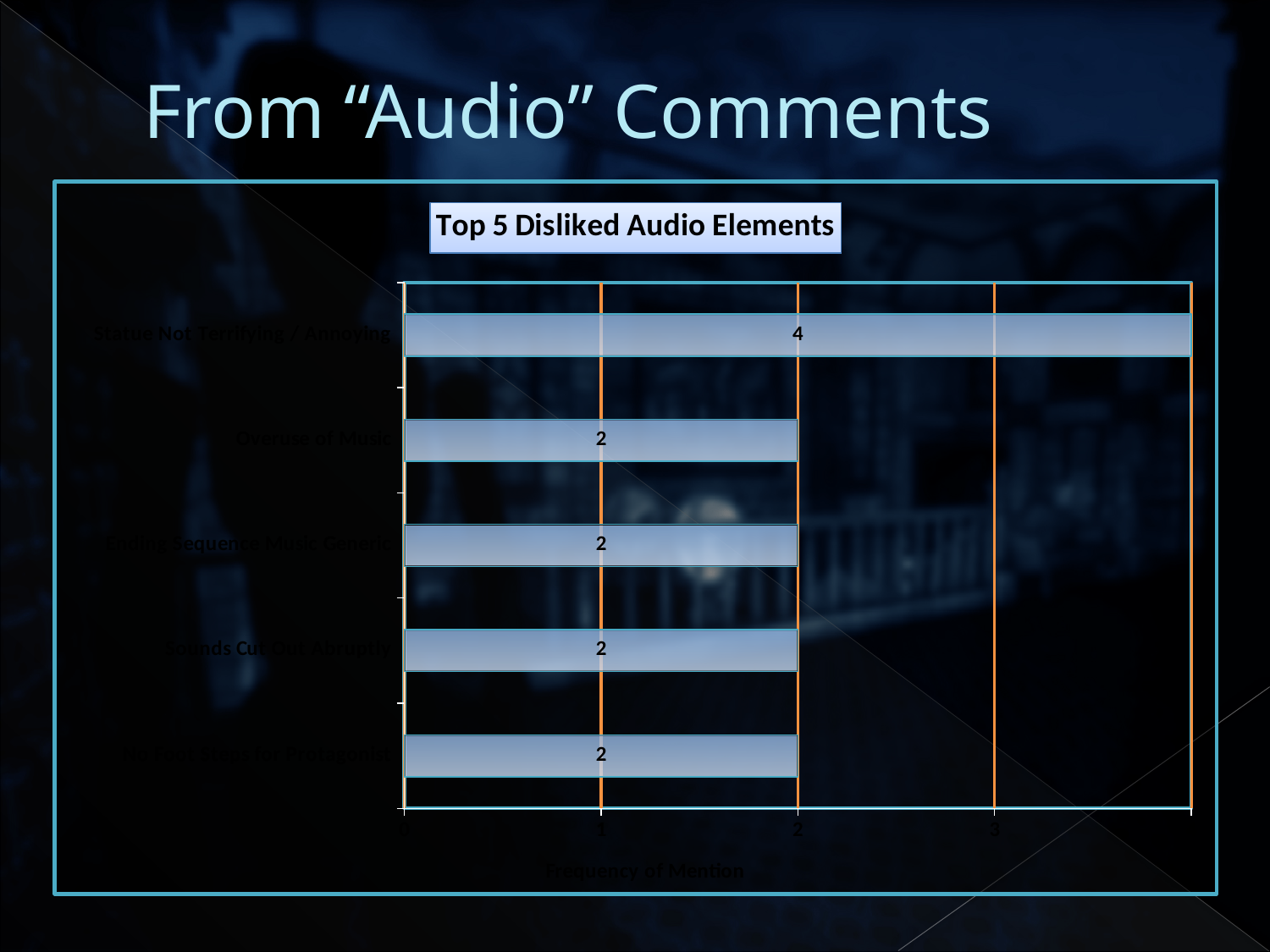
What is the value for No Foot Steps for Protagonist? 2 Is the value for Statue Not Terrifying / Annoying greater or less than 3? greater What is the title of the chart? Top 5 Disliked Audio Elements What is the value for Statue Not Terrifying / Annoying? 4 What kind of chart is shown on the slide? bar chart Which category has the highest value? Statue Not Terrifying / Annoying What is the difference between the values for Statue Not Terrifying / Annoying and Ending Sequence Music Generic? 2 What is the value for Overuse of Music? 2 How many categories are shown in the chart? 5 Which is larger, the value for Statue Not Terrifying / Annoying or the value for Overuse of Music? Statue Not Terrifying / Annoying What is the value for Sounds Cut Out Abruptly? 2 What is the label of the horizontal axis? Frequency of Mention